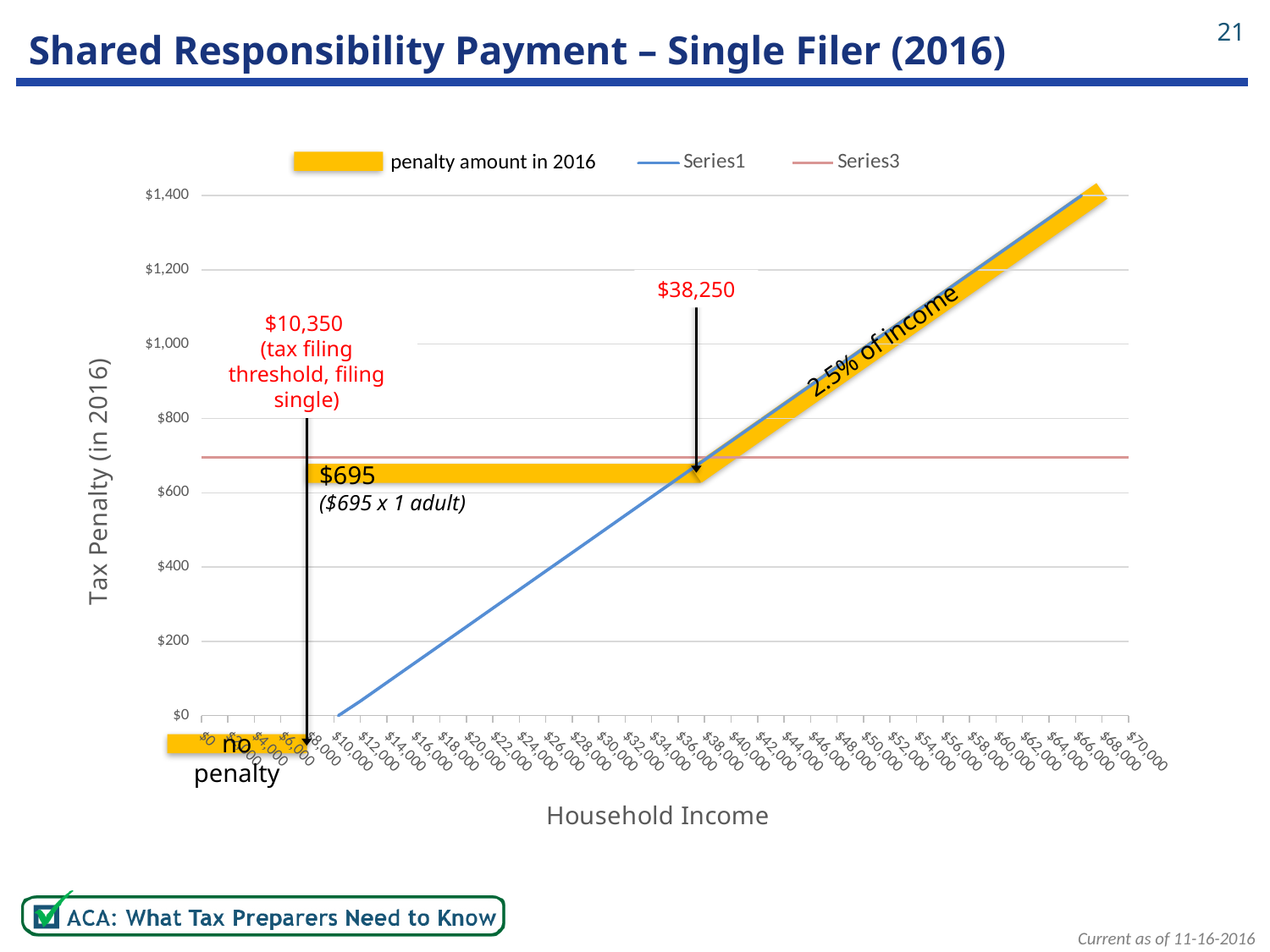
How many series does the chart legend list? 3 What flat penalty amount is labelled on the yellow 'penalty amount in 2016' line? $695 What kind of chart is shown on the slide? line chart What percentage of income is labelled along the rising part of the penalty line? 2.5% of income Does the 'penalty amount in 2016' line rise or fall as household income increases from $38,250 to $70,000? rise Is the value of the 'penalty amount in 2016' line at a household income of $60,000 greater or less than $1,000? greater At what household income does the chart mark the point where the penalty switches from the flat amount to the percentage of income? $38,250 Is the value of the horizontal Series3 line greater or less than $800? less What is the title of the y axis of the chart? Tax Penalty (in 2016) What is the title of the x axis of the chart? Household Income Is the value of Series1 at a household income of $30,000 greater or less than $400? greater At what household income does the chart mark the tax filing threshold for filing single? $10,350